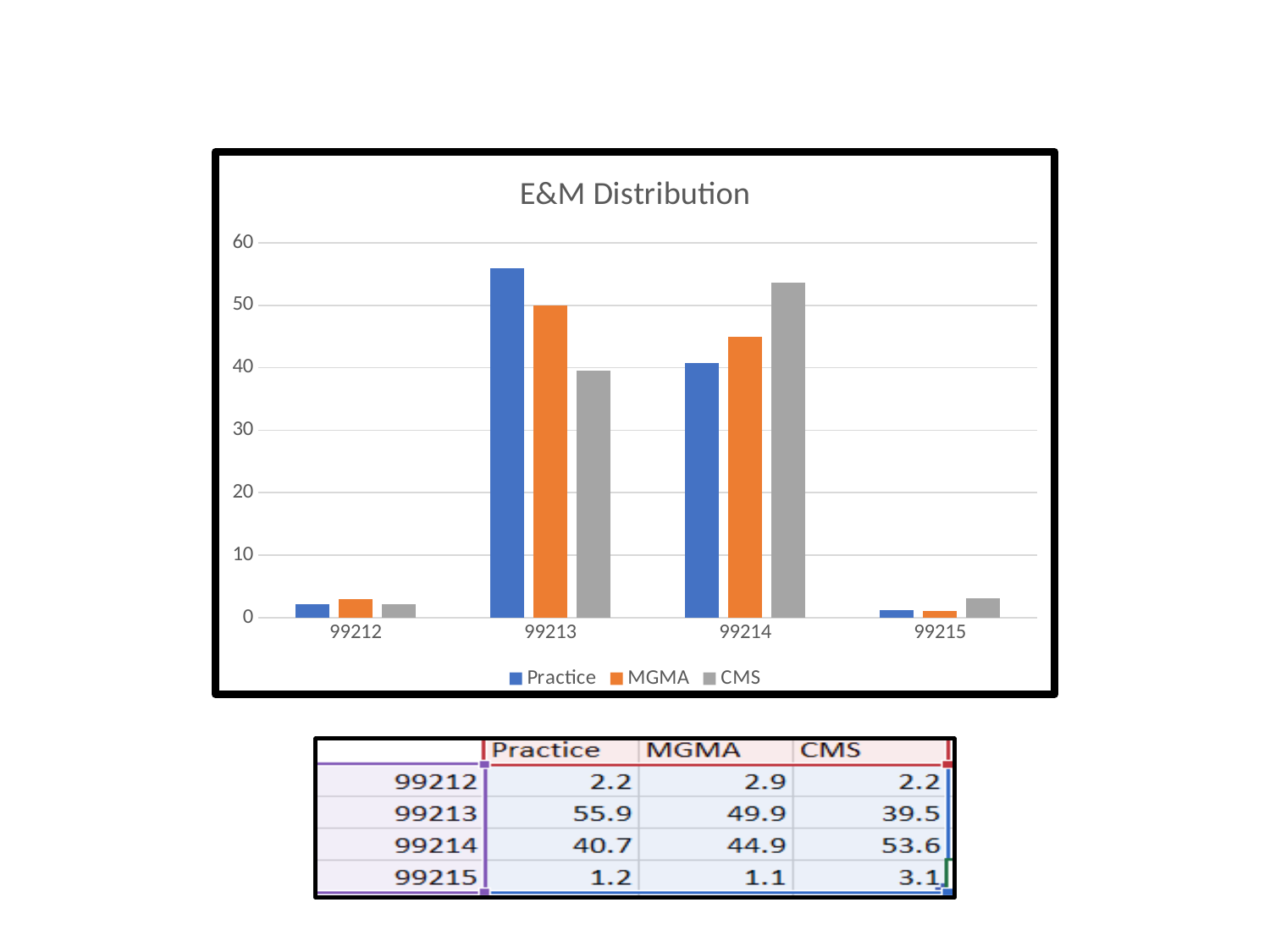
For 99214, which is larger: the MGMA value or the Practice value? MGMA What is the MGMA value for 99212? 2.9 How many categories are shown on the x axis? 4 Which category has the highest CMS value? 99214 What is the Practice value for 99213? 55.9 What is the CMS value for 99214? 53.6 Is the MGMA value for 99213 greater or less than 40? greater Which category has the lowest Practice value? 99215 What type of chart is shown on the slide? bar chart What is the difference between the Practice and CMS values for 99213? 16.4 How many series does the legend list? 3 What is the title of the chart? E&M Distribution